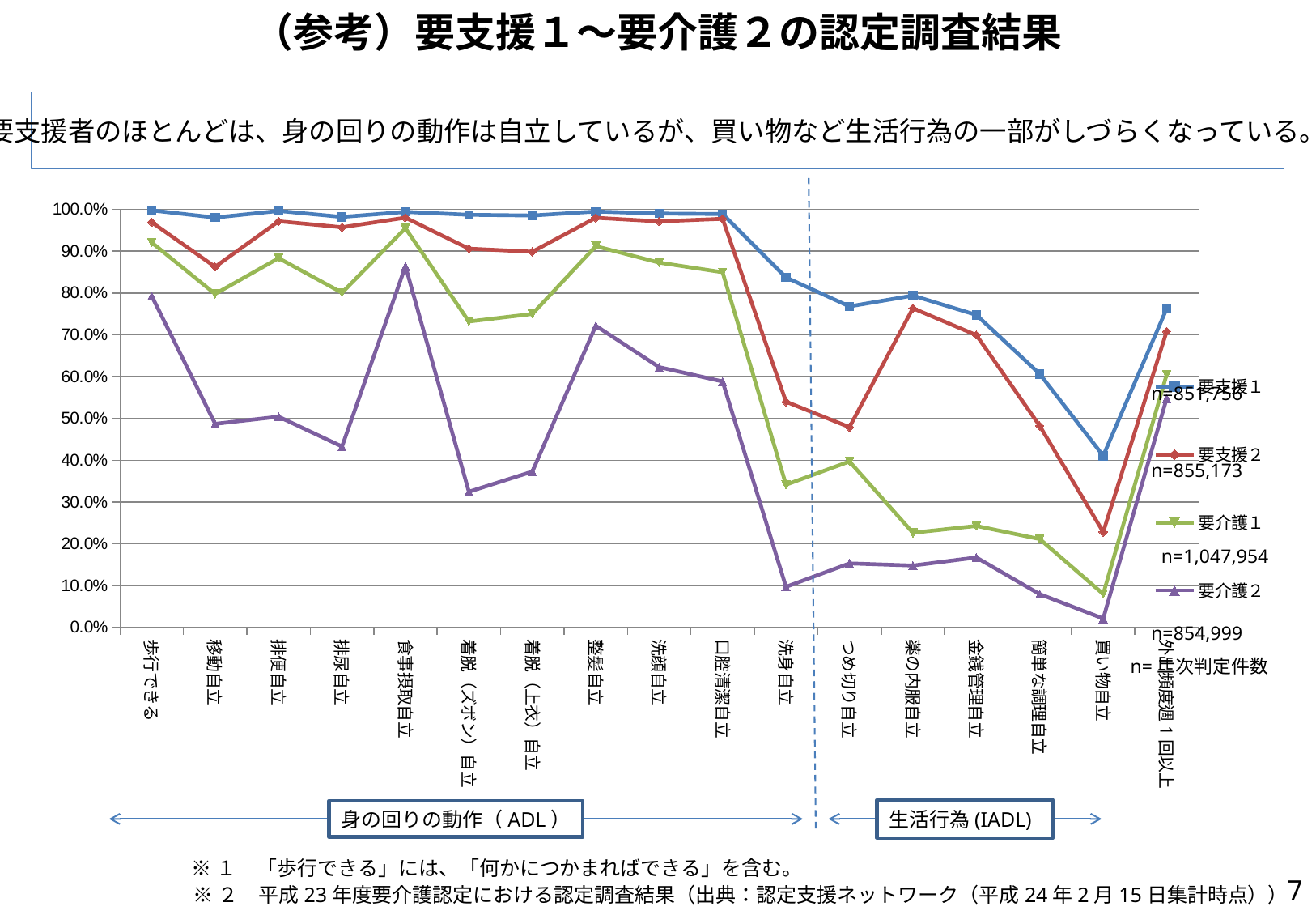
How many categories are plotted along the x axis of the chart? 17 Is the value for 要支援1 at 買い物自立 greater or less than 30.0%? greater How many series does the chart's legend list? 4 At 歩行できる, which series has the larger value, 要支援2 or 要介護1? 要支援2 Is the value for 要介護1 at 薬の内服自立 greater or less than 30.0%? less What kind of chart is shown on the slide? line chart Between 簡単な調理自立 and 買い物自立, do the values of all four series rise or fall? fall Is the value for 要介護2 at 洗身自立 greater or less than 20.0%? less For the 要介護2 series, which category has the highest value? 食事摂取自立 At 買い物自立, which series has the larger value, 要支援1 or 要介護2? 要支援1 For the 要介護2 series, which category has the lowest value? 買い物自立 What sample size (n) is shown in the legend for 要介護1? n=1,047,954